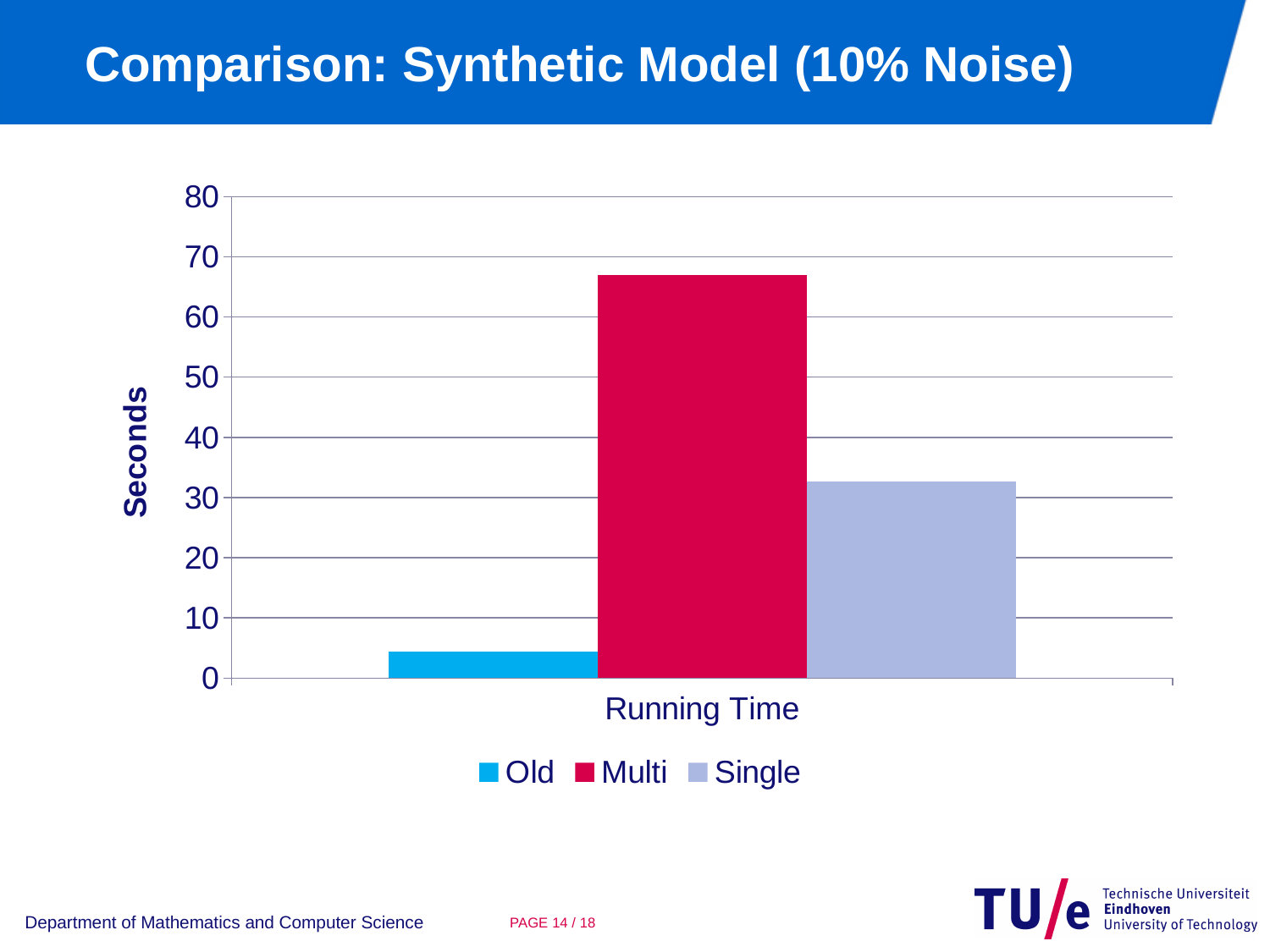
Which series has the highest running time? Multi Is the value for Multi greater or less than 70? less How many series does the legend list? 3 Is the value for Multi greater or less than 60? greater Which is larger, the value for Multi or the value for Single? Multi What is the label on the vertical axis? Seconds Which series has the lowest running time? Old Which is larger, the value for Single or the value for Old? Single What is the category label on the horizontal axis? Running Time Is the value for Single greater or less than 30? greater What kind of chart is shown on the slide? bar chart